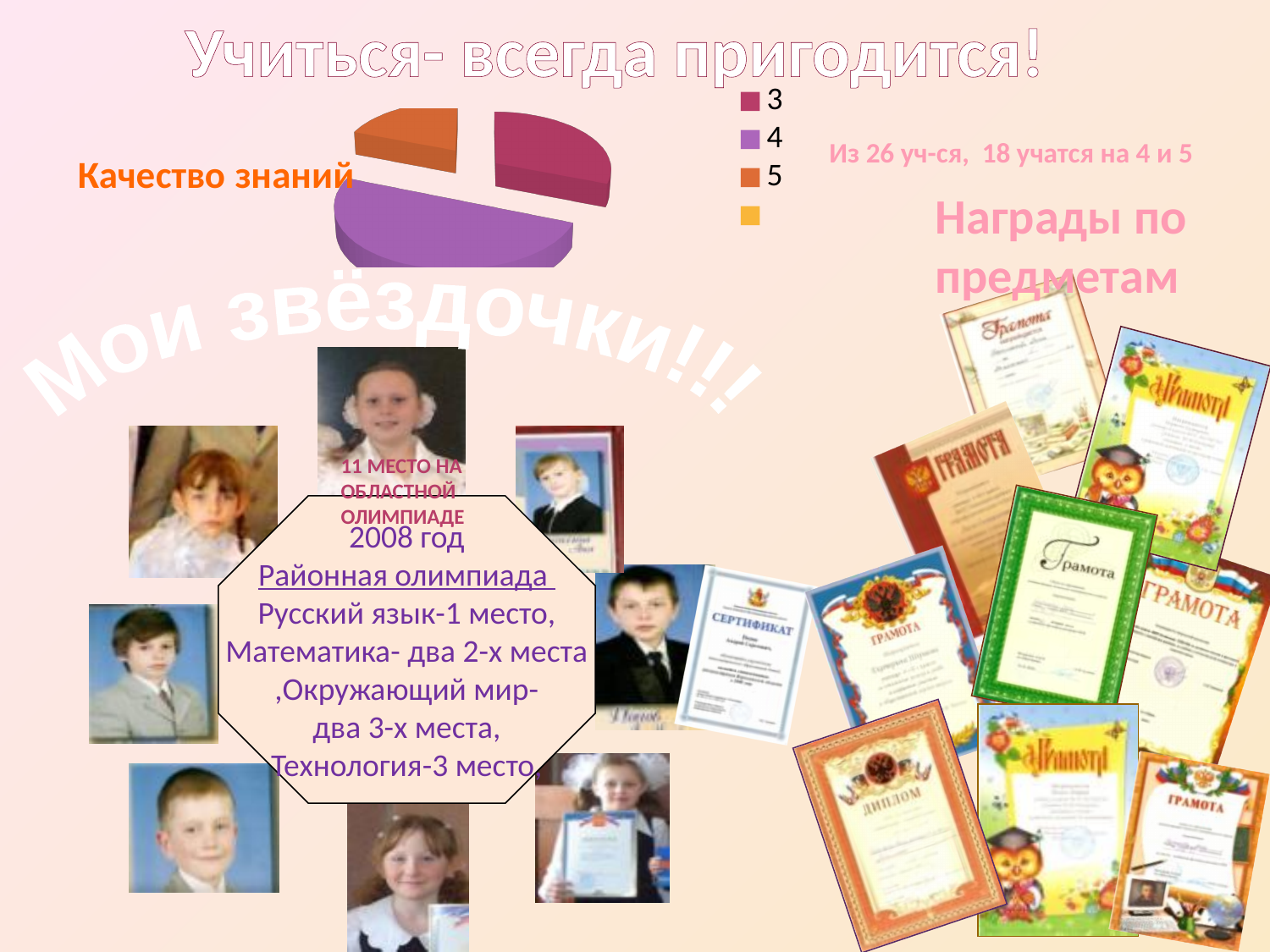
How many slices are visible in the "Качество знаний" pie chart? 3 Which category has the largest slice in the "Качество знаний" pie chart? 4 What labelled categories does the legend of the "Качество знаний" pie chart list? 3, 4, 5 In the "Качество знаний" pie chart, which slice is larger, the one for 4 or the one for 3? 4 In the "Качество знаний" pie chart, which slice is larger, the one for 4 or the one for 5? 4 What colour is the slice for category 4 in the "Качество знаний" pie chart? purple What kind of chart is shown under the heading "Качество знаний"? pie chart